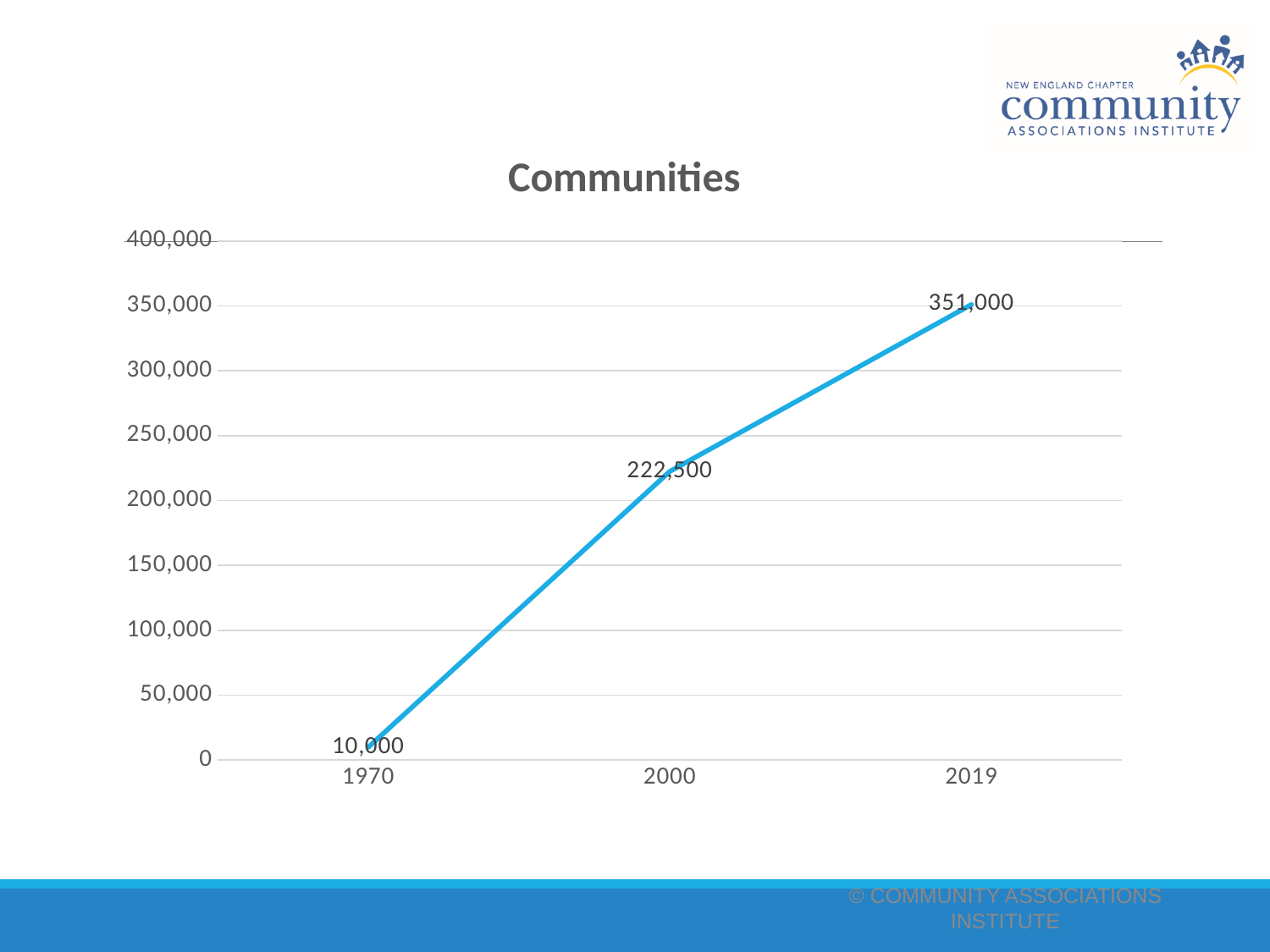
Which year has the highest value? 2019 Which year has the lowest value? 1970 Which is larger, the value for 2000 or the value for 1970? 2000 What is the value for 1970? 10,000 What is the difference between the values for 2019 and 2000? 128,500 What is the value for 2019? 351,000 How many data points are plotted on the chart? 3 Do the values rise or fall from 1970 to 2019? rise What is the difference between the values for 2000 and 1970? 212,500 What is the value for 2000? 222,500 What kind of chart is shown? line chart Is the value for 2000 greater or less than 200,000? greater